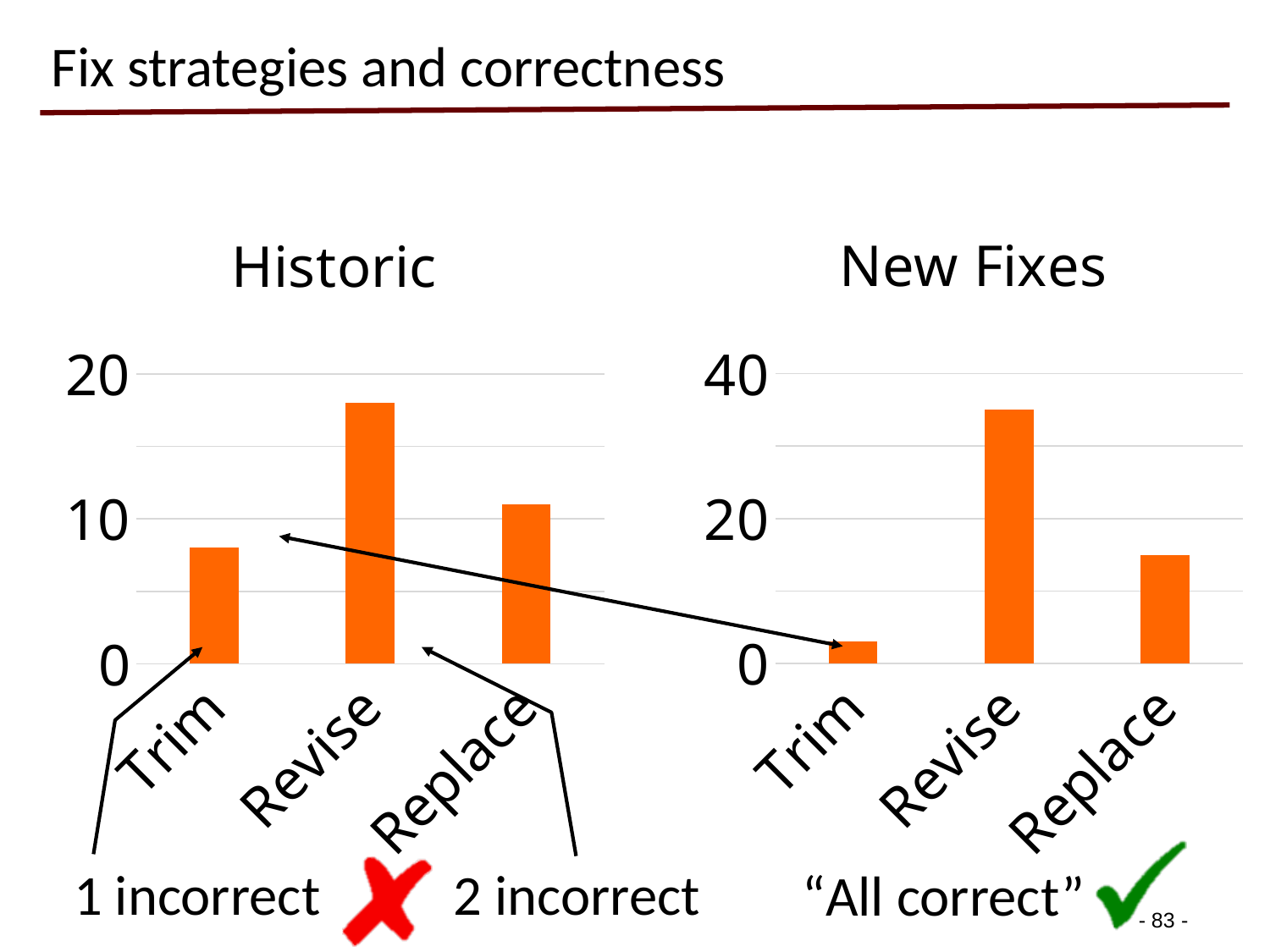
In the Historic chart, which category has the highest bar? Revise In the New Fixes chart, is the value for Revise greater or less than 20? greater In the Historic chart, which category has the lowest bar? Trim In the Historic chart, which is larger, the value for Revise or the value for Replace? Revise What kind of chart is the Historic chart? bar chart In the Historic chart, is the value for Revise greater or less than 10? greater In the New Fixes chart, is the value for Trim greater or less than 20? less In the New Fixes chart, which category has the highest bar? Revise In the New Fixes chart, which category has the lowest bar? Trim How many categories are shown in the New Fixes chart? 3